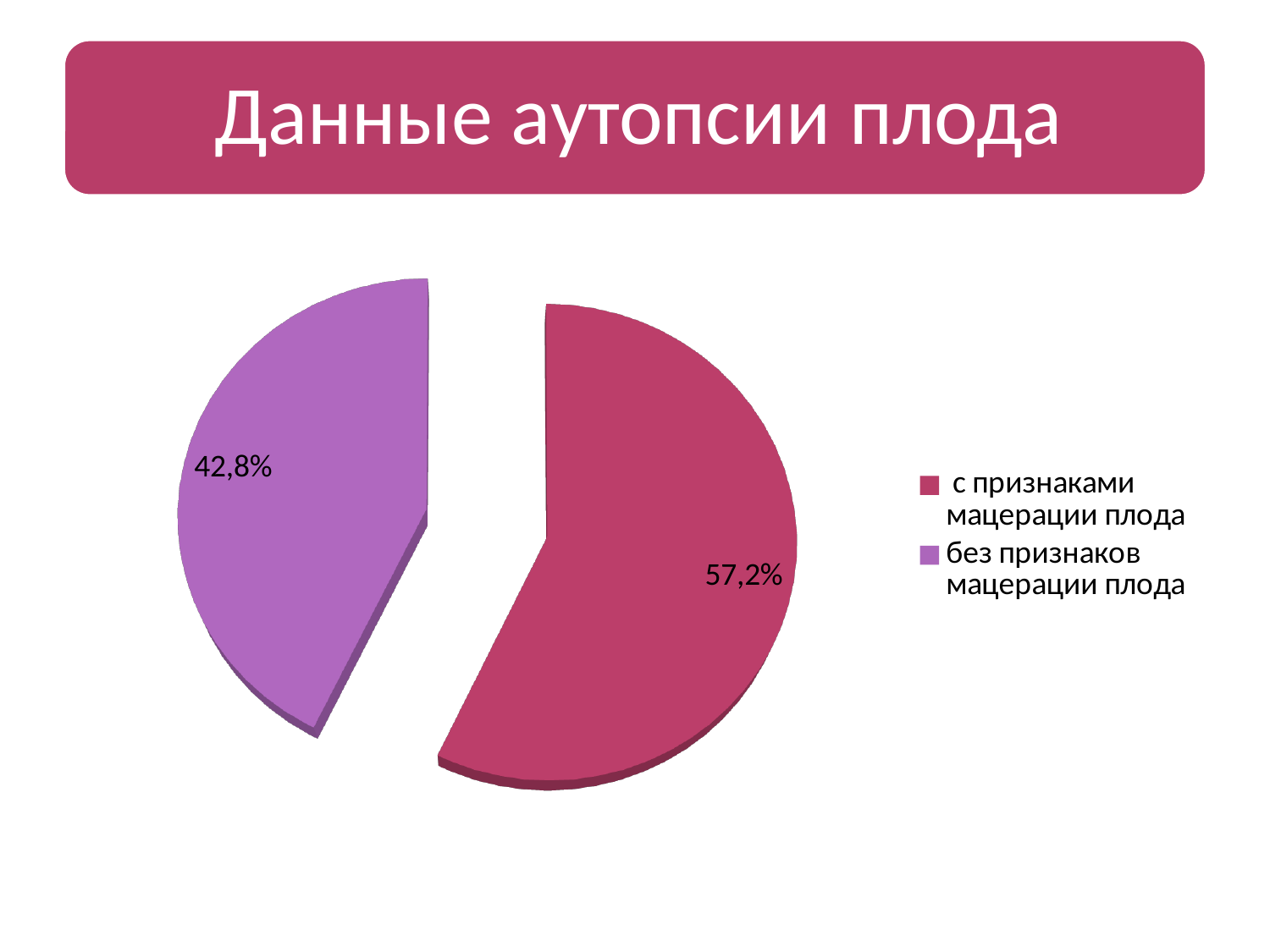
What share of the pie is labelled 'без признаков мацерации плода'? 42,8% How many entries does the legend list? 2 What is the title of the slide? Данные аутопсии плода Which category has the smallest slice of the pie? без признаков мацерации плода Which category has the largest slice of the pie? с признаками мацерации плода What is the difference in percentage points between the 'с признаками мацерации плода' slice and the 'без признаков мацерации плода' slice? 14,4% How many slices does the pie chart have? 2 What share of the pie is labelled 'с признаками мацерации плода'? 57,2% Is the share for 'с признаками мацерации плода' greater or less than 50%? greater Which is larger: the slice for 'с признаками мацерации плода' or the slice for 'без признаков мацерации плода'? с признаками мацерации плода What colour is the slice for 'без признаков мацерации плода'? purple What type of chart is shown on the slide? pie chart